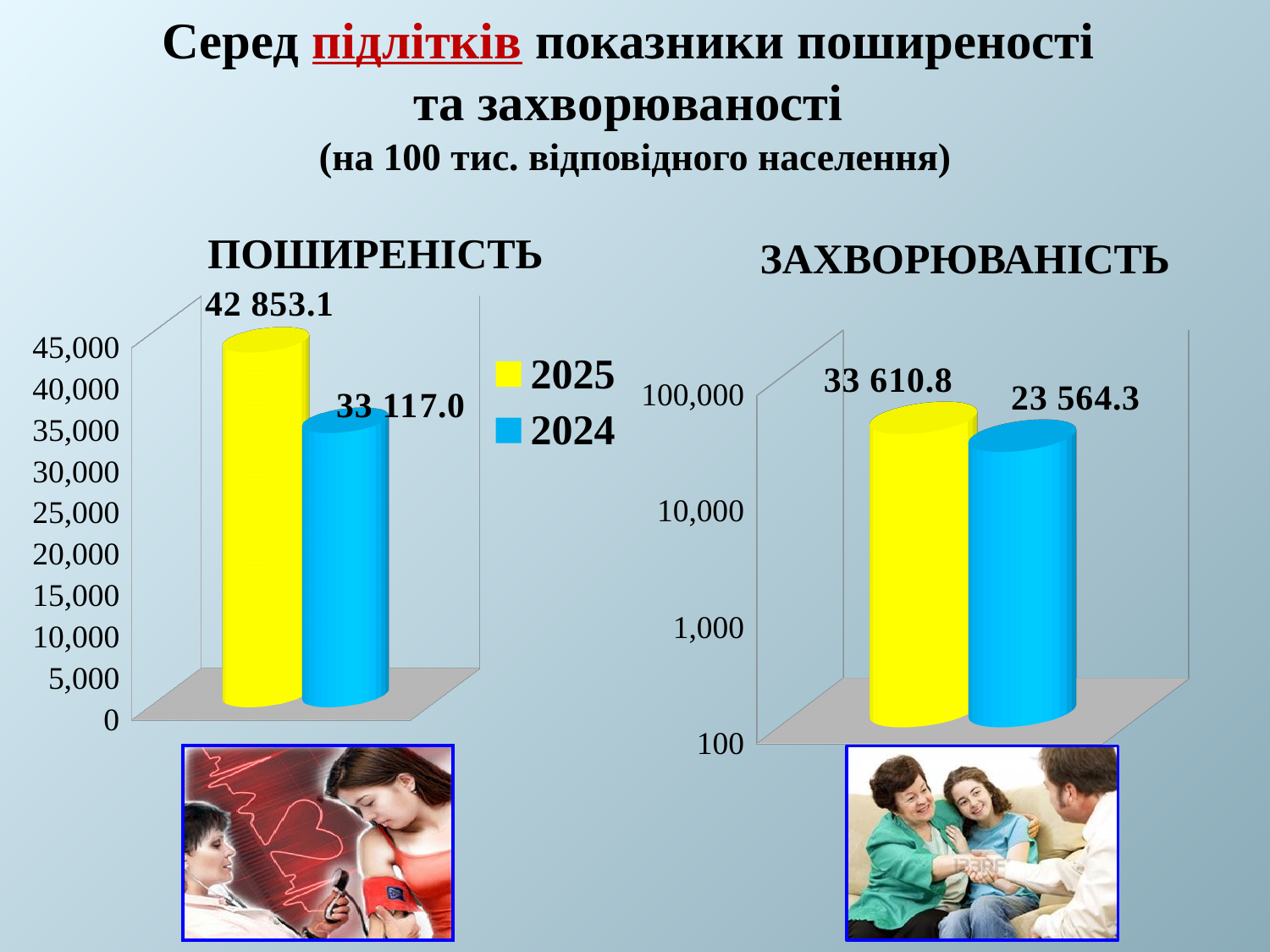
In the ПОШИРЕНІСТЬ chart, is the value for 2024 greater or less than 35,000? less In the ПОШИРЕНІСТЬ chart, what is the value for 2024? 33 117.0 How many series does the legend on the slide list? 2 In the ЗАХВОРЮВАНІСТЬ chart, what is the difference between the 2025 and 2024 values? 10 046.5 In the ЗАХВОРЮВАНІСТЬ chart, what is the value for 2025? 33 610.8 In the ЗАХВОРЮВАНІСТЬ chart, which year has the lower value? 2024 In the ЗАХВОРЮВАНІСТЬ chart, what is the value for 2024? 23 564.3 In the ПОШИРЕНІСТЬ chart, what is the value for 2025? 42 853.1 In the ПОШИРЕНІСТЬ chart, what is the difference between the 2025 and 2024 values? 9 736.1 In the legend, which colour represents 2024? Blue In the ПОШИРЕНІСТЬ chart, which year has the higher value? 2025 What kind of chart is the ЗАХВОРЮВАНІСТЬ chart? Bar chart